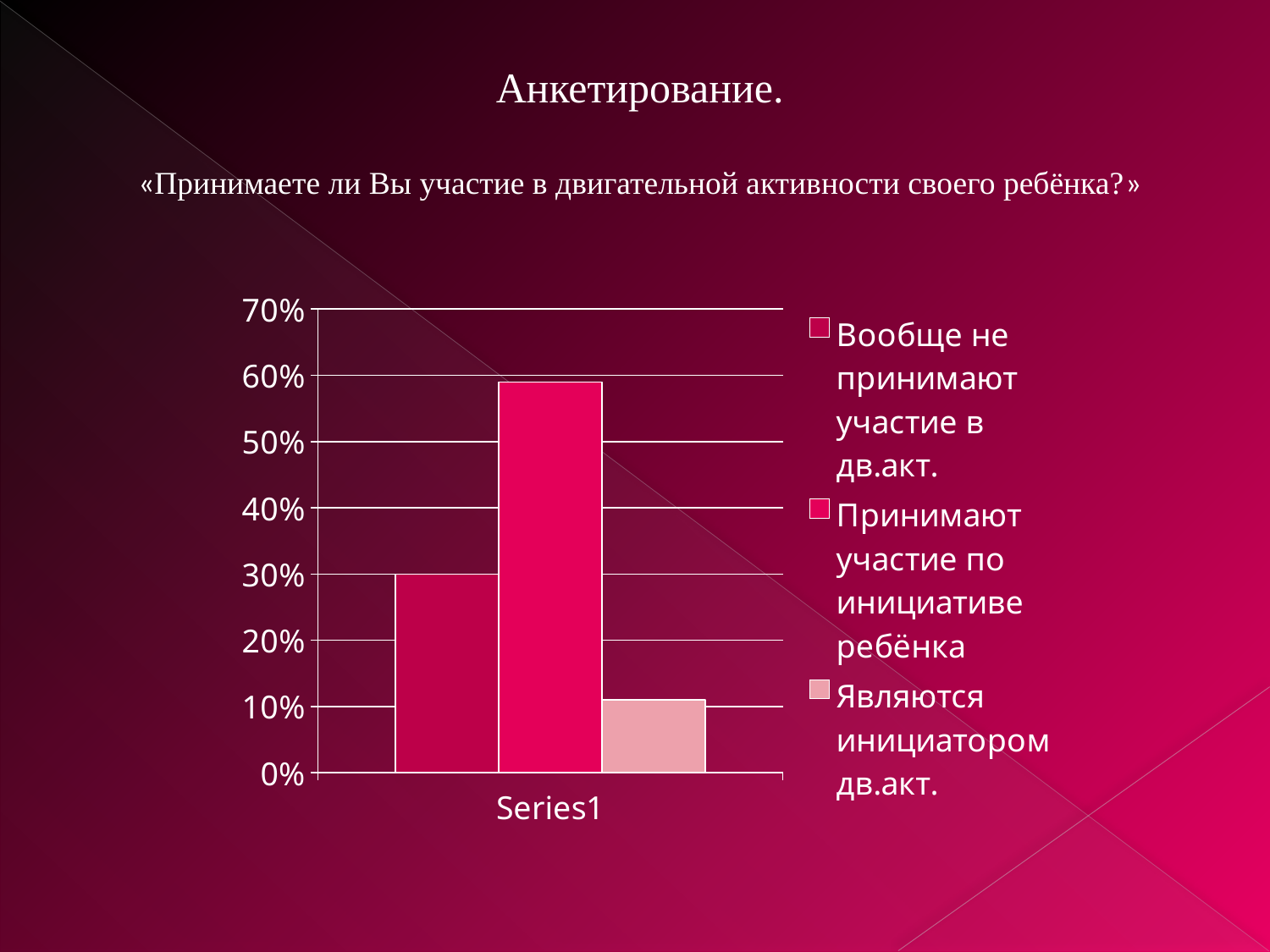
Is the value for "Вообще не принимают участие в дв.акт." greater or less than 20%? greater How many bars are plotted in the chart? 3 How many series does the legend list? 3 Is the value for "Вообще не принимают участие в дв.акт." greater or less than 40%? less Is the value for "Являются инициатором дв.акт." greater or less than 20%? less What label is shown on the horizontal axis of the chart? Series1 Which is larger: the bar for "Принимают участие по инициативе ребёнка" or the bar for "Вообще не принимают участие в дв.акт."? Принимают участие по инициативе ребёнка Which is larger: the bar for "Вообще не принимают участие в дв.акт." or the bar for "Являются инициатором дв.акт."? Вообще не принимают участие в дв.акт. Which legend entry has the highest bar? Принимают участие по инициативе ребёнка What kind of chart is shown on the slide? bar chart Which legend entry has the lowest bar? Являются инициатором дв.акт.